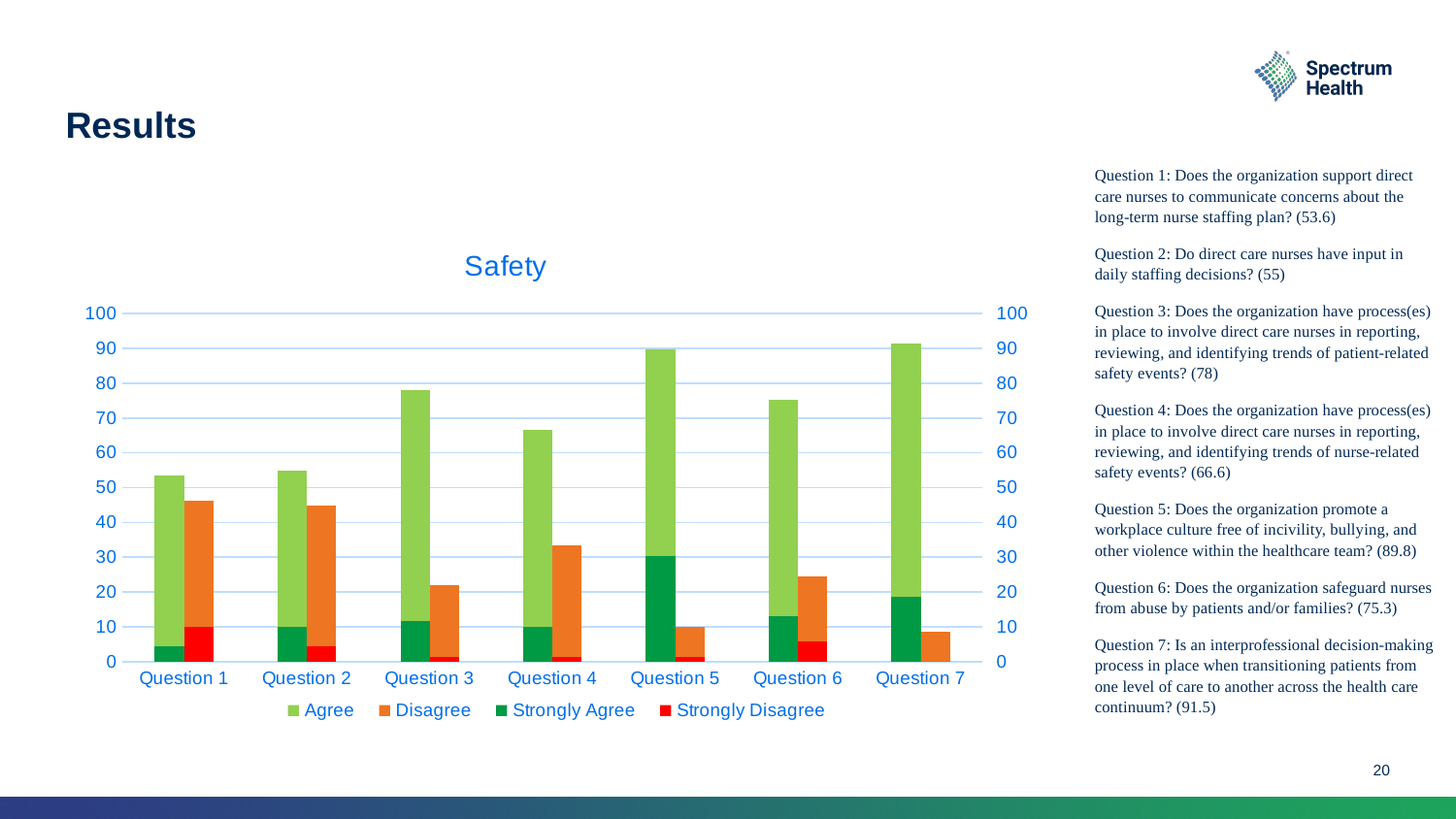
What kind of chart is shown on the slide? Bar chart What is the title of the chart? Safety How many series does the chart legend list? 4 Which colour represents the Strongly Disagree series in the chart? Red Is the Disagree value for Question 1 greater or less than 50? less Is the Strongly Agree value for Question 5 larger or smaller than the Strongly Agree value for Question 7? Larger Which question has the tallest Strongly Disagree segment? Question 1 Which question has the tallest Strongly Agree segment? Question 5 How many questions (categories) are shown on the x axis of the chart? 7 Is the Disagree value for Question 4 larger or smaller than the Disagree value for Question 3? Larger Is the top of the stacked Agree/Strongly Agree bar for Question 5 greater or less than 80? greater